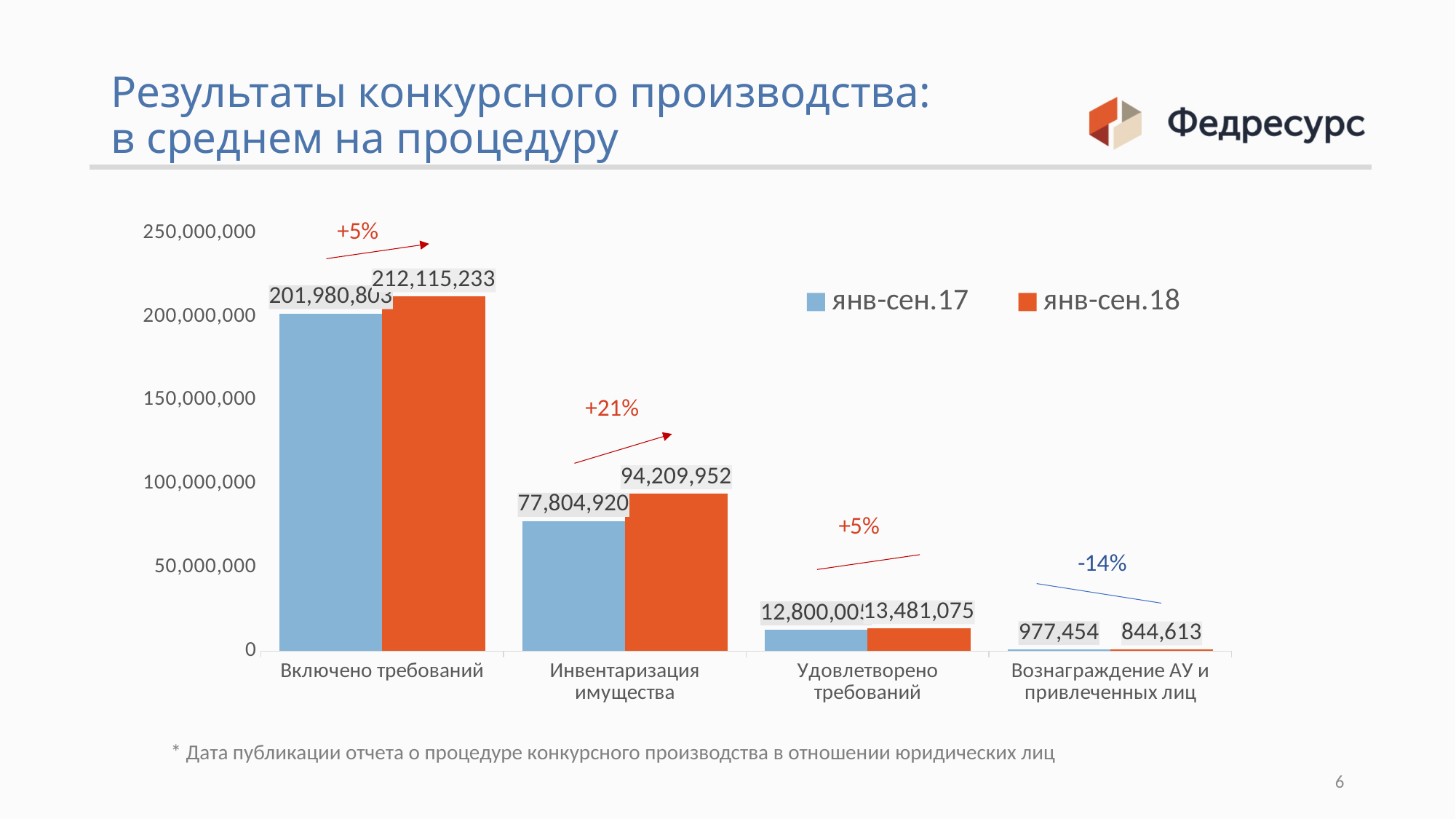
What is the value for янв-сен.17 in the Вознаграждение АУ и привлеченных лиц category? 977,454 What is the difference between the янв-сен.17 and янв-сен.18 values for Вознаграждение АУ и привлеченных лиц? 132,841 What is the difference between the янв-сен.18 and янв-сен.17 values for Инвентаризация имущества? 16,405,032 For Вознаграждение АУ и привлеченных лиц, which series has the larger value, янв-сен.17 or янв-сен.18? янв-сен.17 What is the value for янв-сен.18 in the Инвентаризация имущества category? 94,209,952 Which category has the highest values in the chart? Включено требований What is the value for янв-сен.17 in the Инвентаризация имущества category? 77,804,920 What percentage change is annotated above the Инвентаризация имущества bars? +21% What is the value for янв-сен.18 in the Удовлетворено требований category? 13,481,075 Which category has the lowest values in the chart? Вознаграждение АУ и привлеченных лиц How many series does the legend list? 2 What is the value for янв-сен.18 in the Включено требований category? 212,115,233